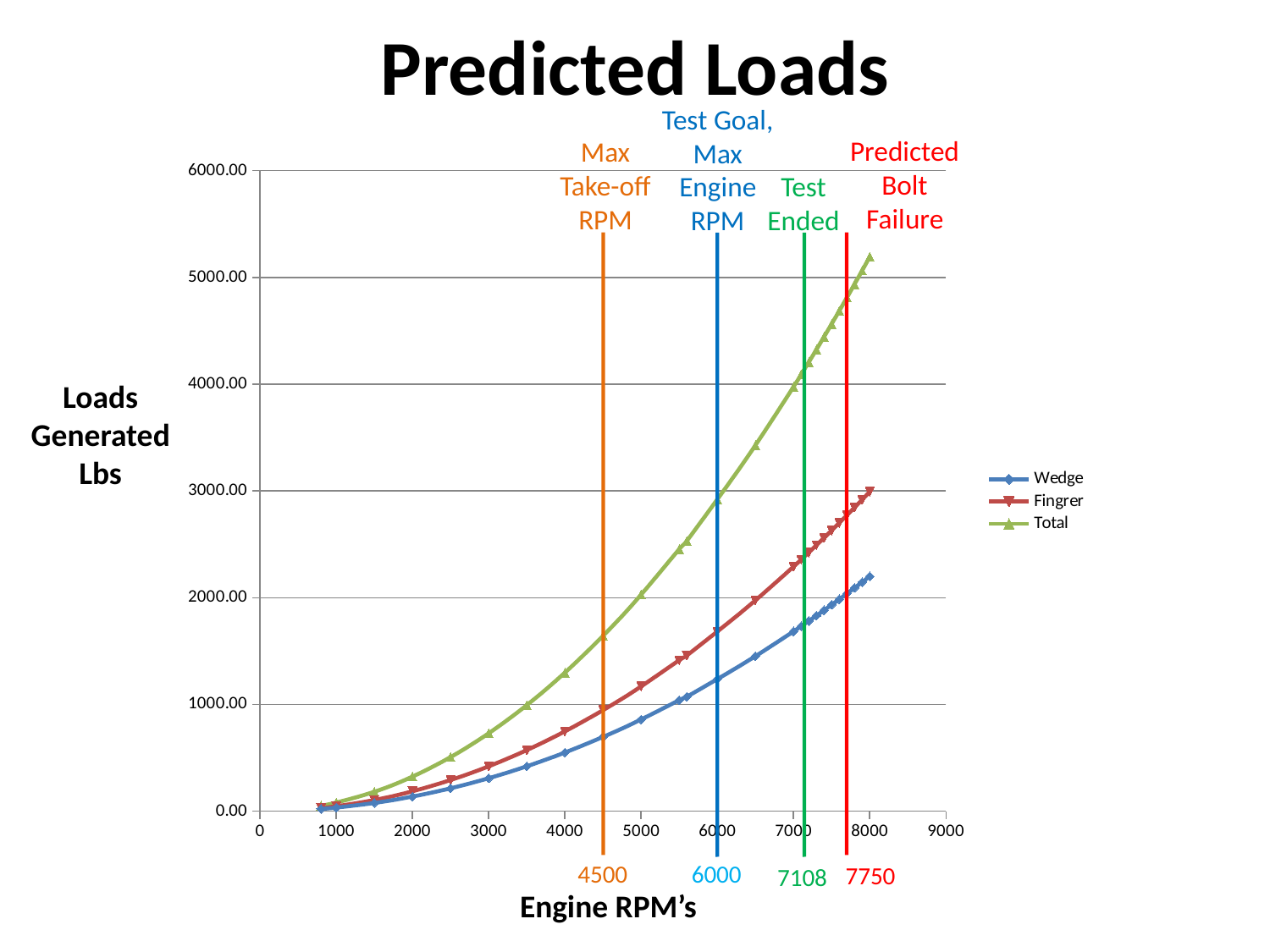
Is the Total load at 8000 RPM greater or less than 5000.00? greater Is the Wedge load at 8000 RPM greater or less than 2000.00? greater What is the title of the chart? Predicted Loads At 5000 RPM, which is larger: the Fingrer load or the Wedge load? Fingrer Which series has the lowest load at 8000 RPM? Wedge At what engine RPM is the Predicted Bolt Failure line marked? 7750 Is the Total load at 6000 RPM greater or less than 3000.00? less Which series has the highest load at 8000 RPM? Total How many series does the legend list? 3 What kind of chart is shown on the slide? line chart Do the plotted loads rise or fall as engine RPM increases? rise